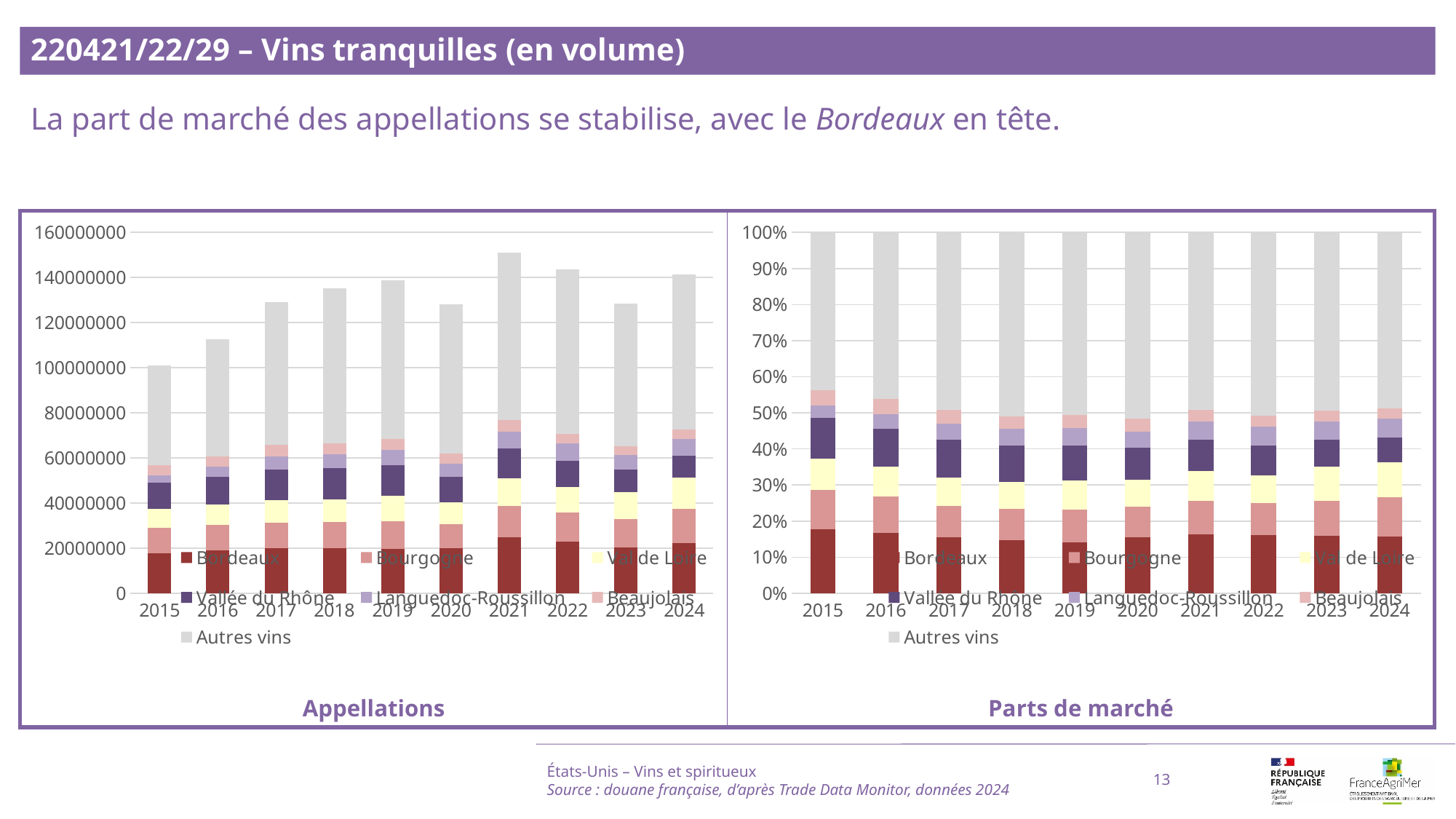
In the Appellations chart, is the total bar for 2021 greater or less than 140000000? greater In the Appellations chart, which year has the larger total bar, 2021 or 2023? 2021 How many series does the legend of the Parts de marché chart list? 7 What kind of chart is the Appellations chart on the left? Stacked bar chart Which legend entry is shown in grey in both charts? Autres vins In the Appellations chart, which year has the lowest total bar? 2015 How many years are shown on the x axis of the Appellations chart? 10 In the Parts de marché chart, what is the total of each stacked bar? 100% In the Parts de marché chart, is the Autres vins share in 2015 greater or less than 40%? greater In the Appellations chart, which year has the highest total bar? 2021 In the Appellations chart, is the total bar for 2015 greater or less than 120000000? less In the Appellations chart, do the total bars generally rise or fall from 2015 to 2021? rise